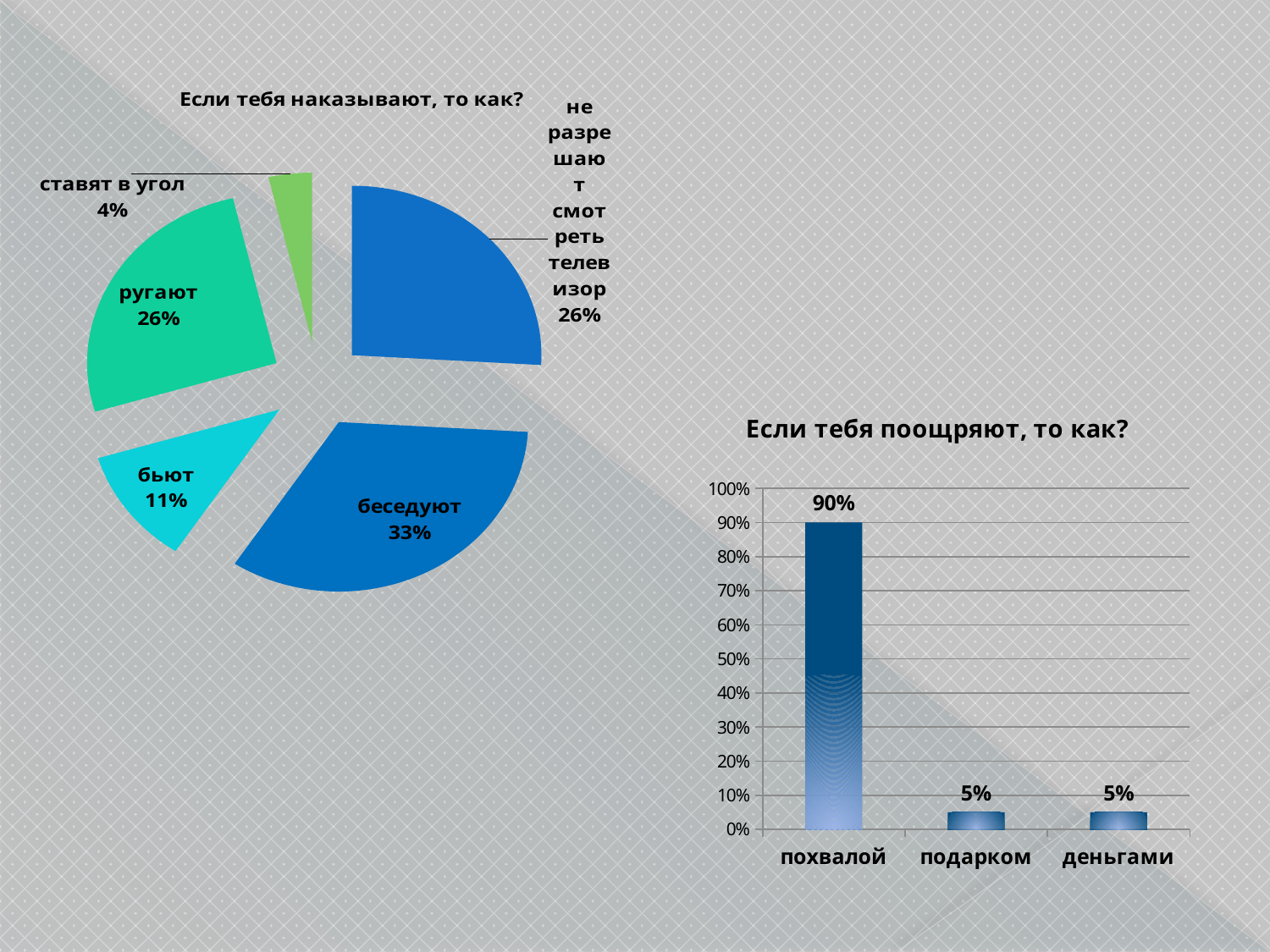
In the pie chart "Если тебя наказывают, то как?", which is larger: the share for "ругают" or the share for "бьют"? ругают In the pie chart "Если тебя наказывают, то как?", what share is labelled for "беседуют"? 33% In the chart "Если тебя поощряют, то как?", which category has the highest value? похвалой In the chart "Если тебя поощряют, то как?", what is the value for "похвалой"? 90% In the chart "Если тебя поощряют, то как?", what is the value for "деньгами"? 5% In the chart "Если тебя поощряют, то как?", what is the difference between the values for "похвалой" and "подарком"? 85% What kind of chart is "Если тебя поощряют, то как?"? bar chart In the pie chart "Если тебя наказывают, то как?", how many slices are there? 5 In the pie chart "Если тебя наказывают, то как?", what is the difference between the shares for "беседуют" and "ругают"? 7% In the pie chart "Если тебя наказывают, то как?", what share is labelled for "бьют"? 11% In the pie chart "Если тебя наказывают, то как?", which category has the largest slice? беседуют In the pie chart "Если тебя наказывают, то как?", which category has the smallest slice? ставят в угол